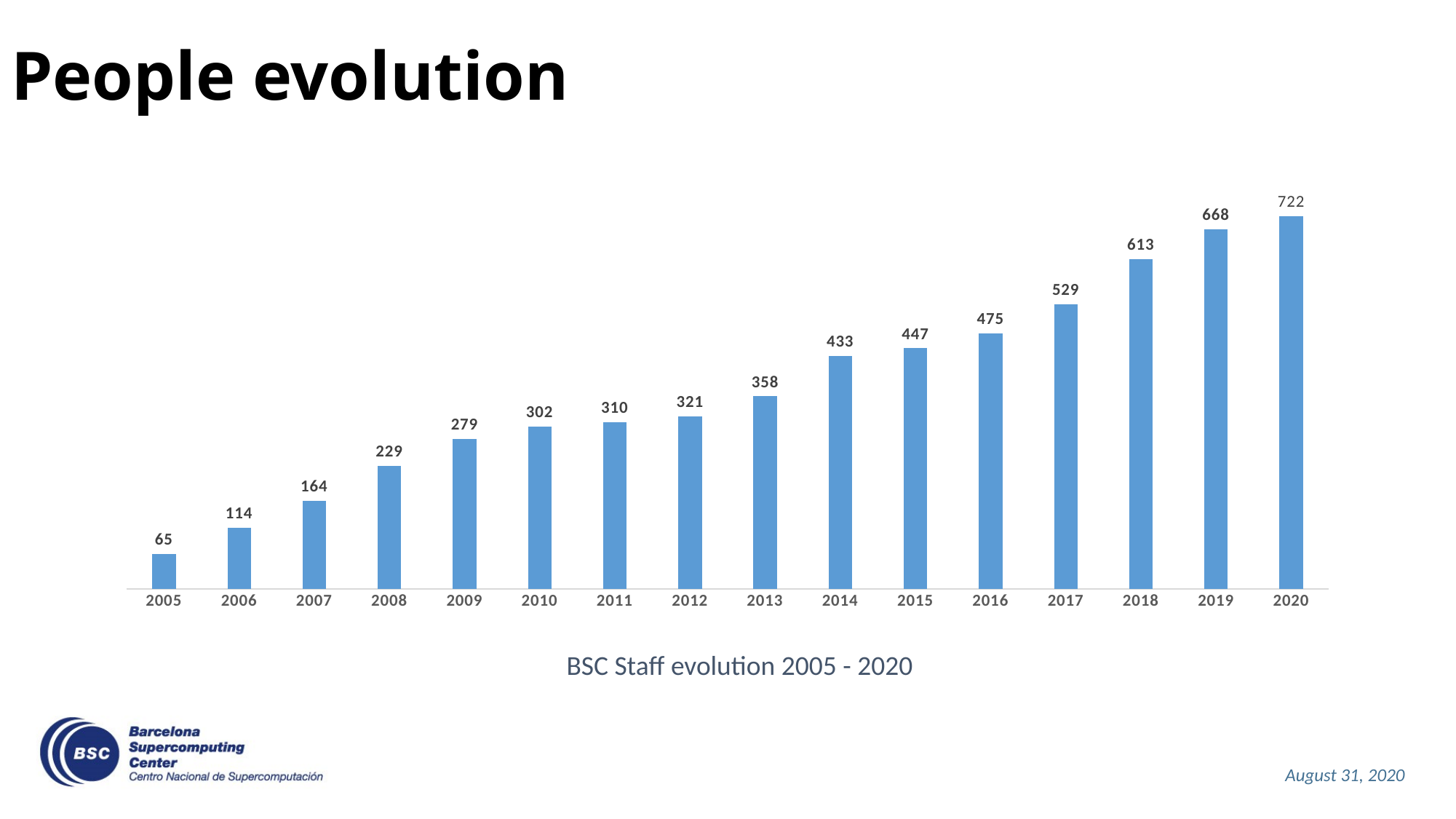
What value is shown for 2017? 529 What was the BSC staff count in 2010? 302 Do the values rise or fall from 2005 to 2020? Rise How much did the staff count increase from 2005 to 2020? 657 Which year has the lowest staff count? 2005 Which year has the highest staff count? 2020 What is the difference between the staff counts in 2020 and 2019? 54 Which year had more staff, 2014 or 2016? 2016 How many years are shown on the x axis? 16 What was the staff count in 2005? 65 What kind of chart is this? Bar chart What is the caption below the chart? BSC Staff evolution 2005 - 2020